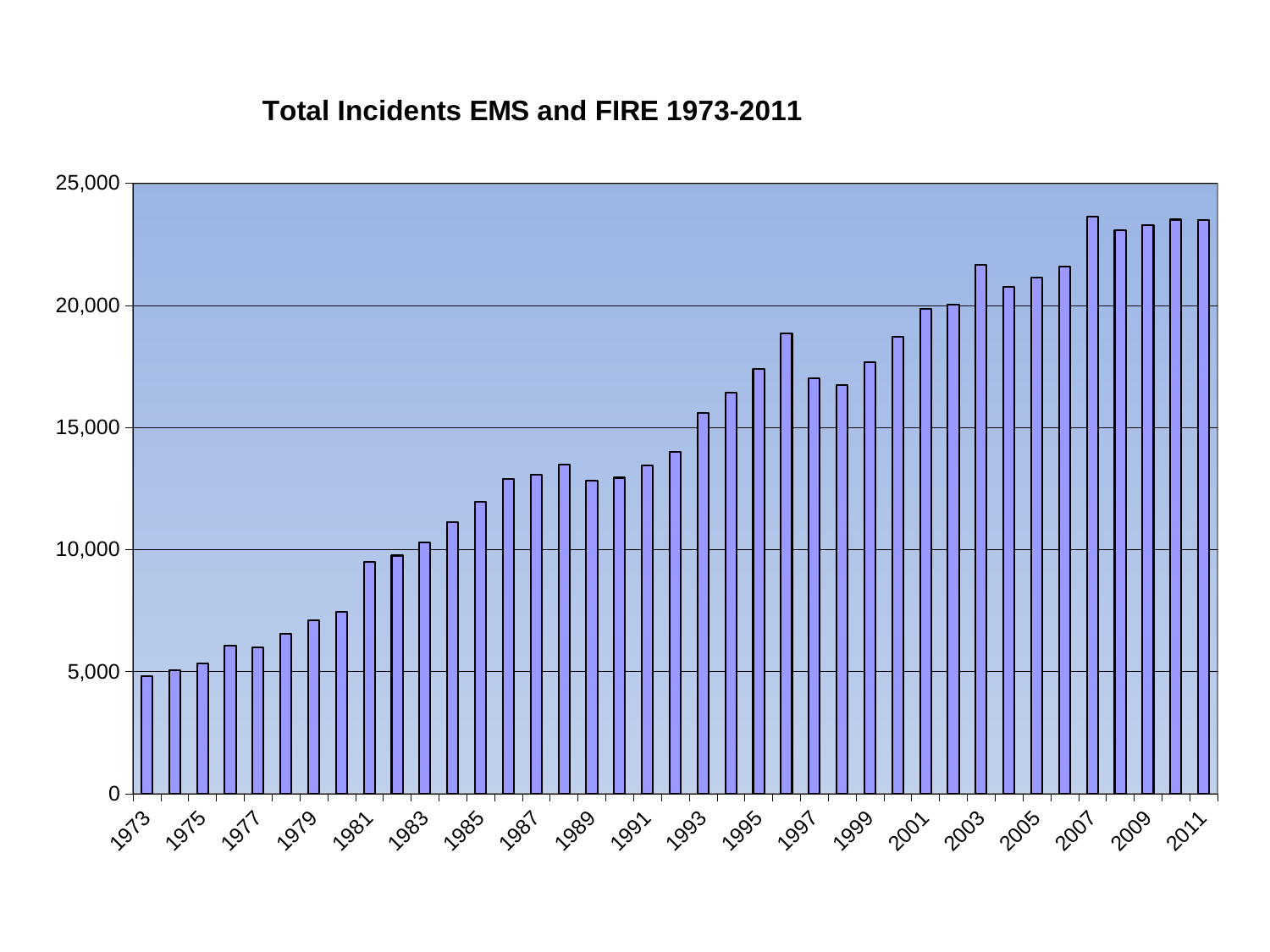
Do total incidents generally rise or fall from 1973 to 2011? Rise Is the value for 2003 greater or less than 20,000? greater What is the title of the chart? Total Incidents EMS and FIRE 1973-2011 How many bars (years) are plotted in the chart? 39 Is the value for 1979 greater or less than 5,000? greater Which year has the higher value, 2003 or 2004? 2003 Is the value for 1996 greater or less than 15,000? greater What kind of chart is shown on the slide? Bar chart Which year has the higher value, 1996 or 1997? 1996 Which year has the lowest total incidents? 1973